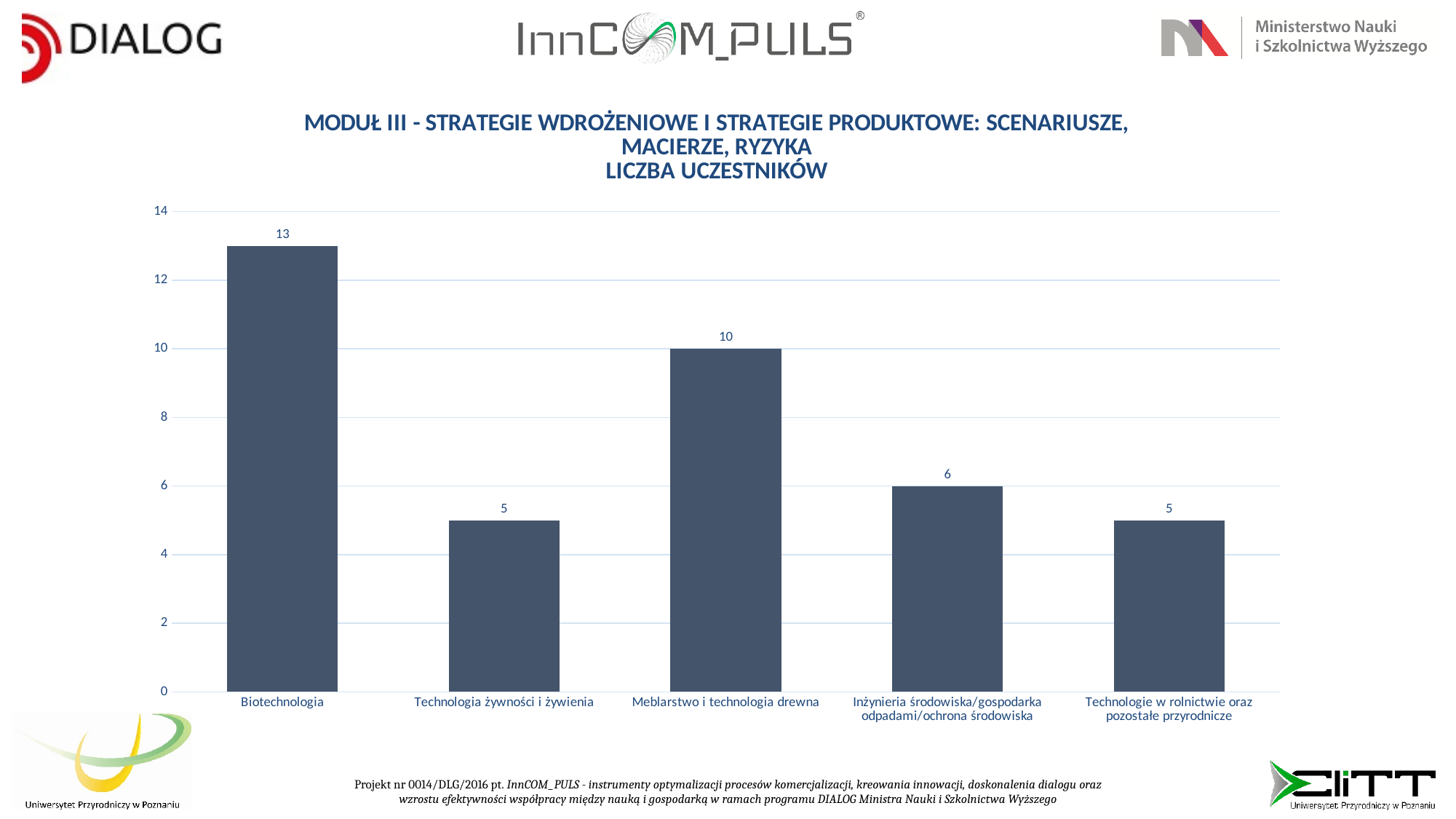
How many categories are shown on the x axis? 5 Which has more participants, Meblarstwo i technologia drewna or Inżynieria środowiska/gospodarka odpadami/ochrona środowiska? Meblarstwo i technologia drewna What is the total number of participants across all five categories? 39 Which category has the highest number of participants? Biotechnologia What is the number of participants for Meblarstwo i technologia drewna? 10 What is the number of participants for Technologia żywności i żywienia? 5 What is the number of participants for Biotechnologia? 13 What is the difference in participants between Inżynieria środowiska/gospodarka odpadami/ochrona środowiska and Technologie w rolnictwie oraz pozostałe przyrodnicze? 1 What is the number of participants for Inżynieria środowiska/gospodarka odpadami/ochrona środowiska? 6 What kind of chart is shown on the slide? Bar chart Is the value for Biotechnologia greater or less than 12? greater What is the difference in participants between Biotechnologia and Meblarstwo i technologia drewna? 3